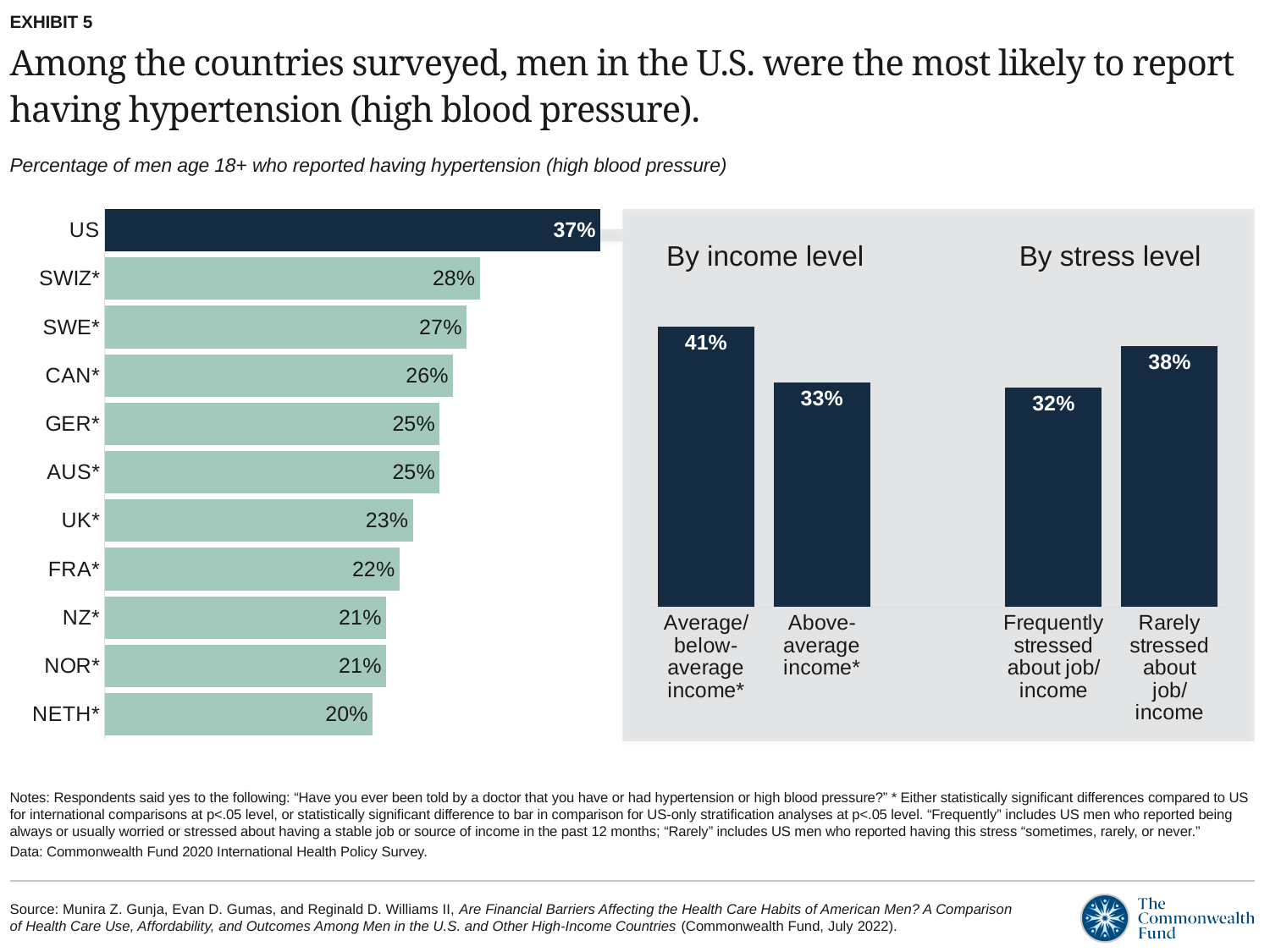
In the 'By income level' chart, what is the difference between the average/below-average income value and the above-average income value? 8 percentage points In the country bar chart on the left, what is the value for CAN*? 26% In the country bar chart on the left, which country has the lowest percentage? NETH* What type of chart is the country chart on the left? Bar chart In the 'By stress level' chart, what is the value for men rarely stressed about job/income? 38% In the 'By income level' chart, what is the value for men with average/below-average income? 41% In the country bar chart on the left, which country has the highest percentage? US In the country bar chart on the left, what percentage of men in the US reported having hypertension? 37% How many countries are shown in the country bar chart on the left? 11 In the country bar chart on the left, which has a higher value, UK* or FRA*? UK* In the country bar chart on the left, what is the difference between the US value and the SWIZ* value? 9 percentage points In the 'By stress level' chart, which group has the higher value, frequently stressed or rarely stressed? Rarely stressed about job/income